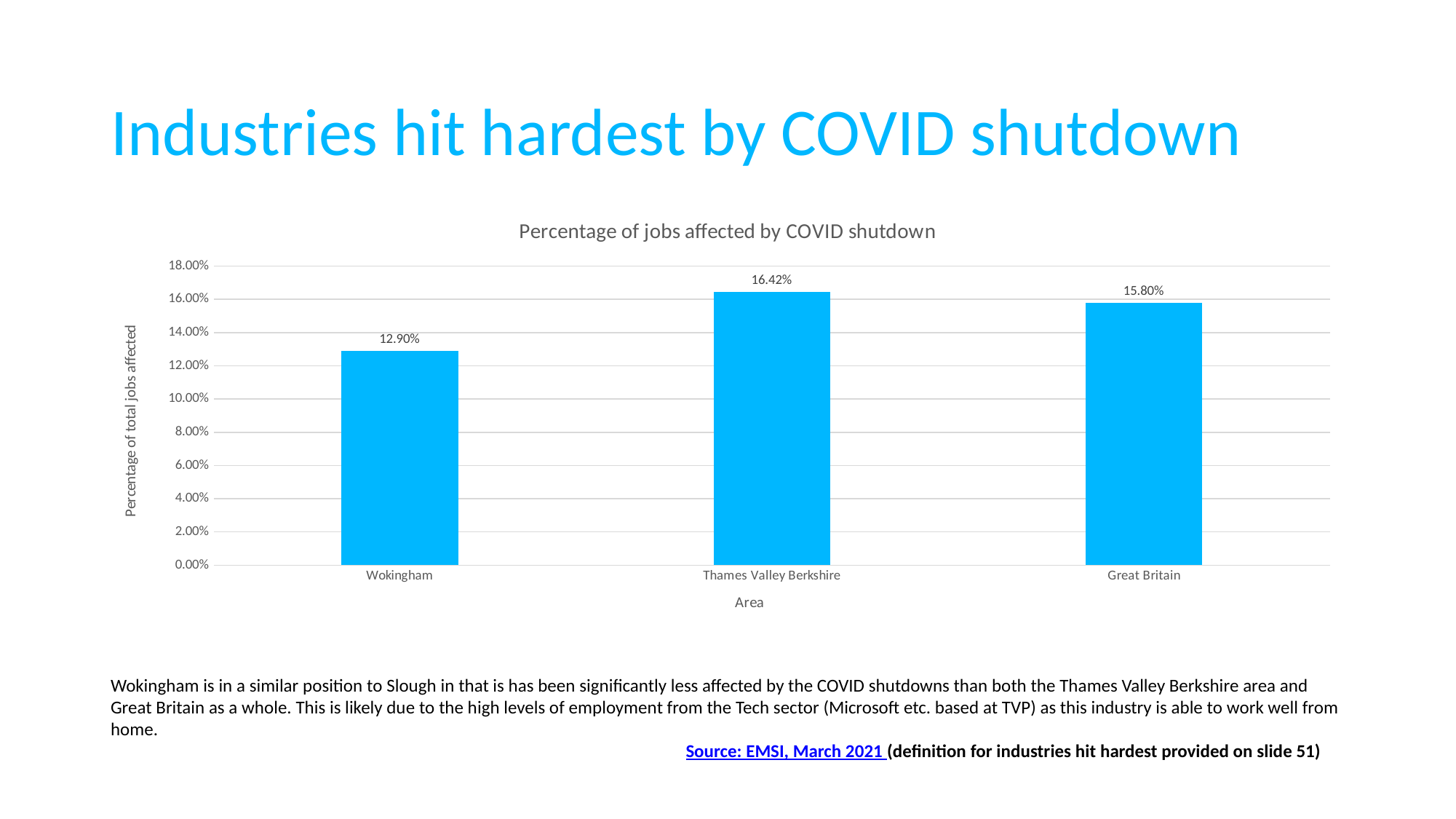
Is the value for Wokingham greater or less than 14.00%? less What is the title of the chart? Percentage of jobs affected by COVID shutdown What is the percentage of jobs affected by COVID shutdown for Great Britain? 15.80% What is the difference in percentage points between Great Britain and Wokingham? 2.90% Which area has the highest percentage of jobs affected by COVID shutdown? Thames Valley Berkshire What is the percentage of jobs affected by COVID shutdown for Thames Valley Berkshire? 16.42% What kind of chart is shown on the slide? Bar chart What is the difference in percentage points between Thames Valley Berkshire and Wokingham? 3.52% Which area has the lowest percentage of jobs affected by COVID shutdown? Wokingham Which has a higher percentage of jobs affected: Great Britain or Wokingham? Great Britain What is the percentage of jobs affected by COVID shutdown for Wokingham? 12.90% How many areas are shown in the chart? 3